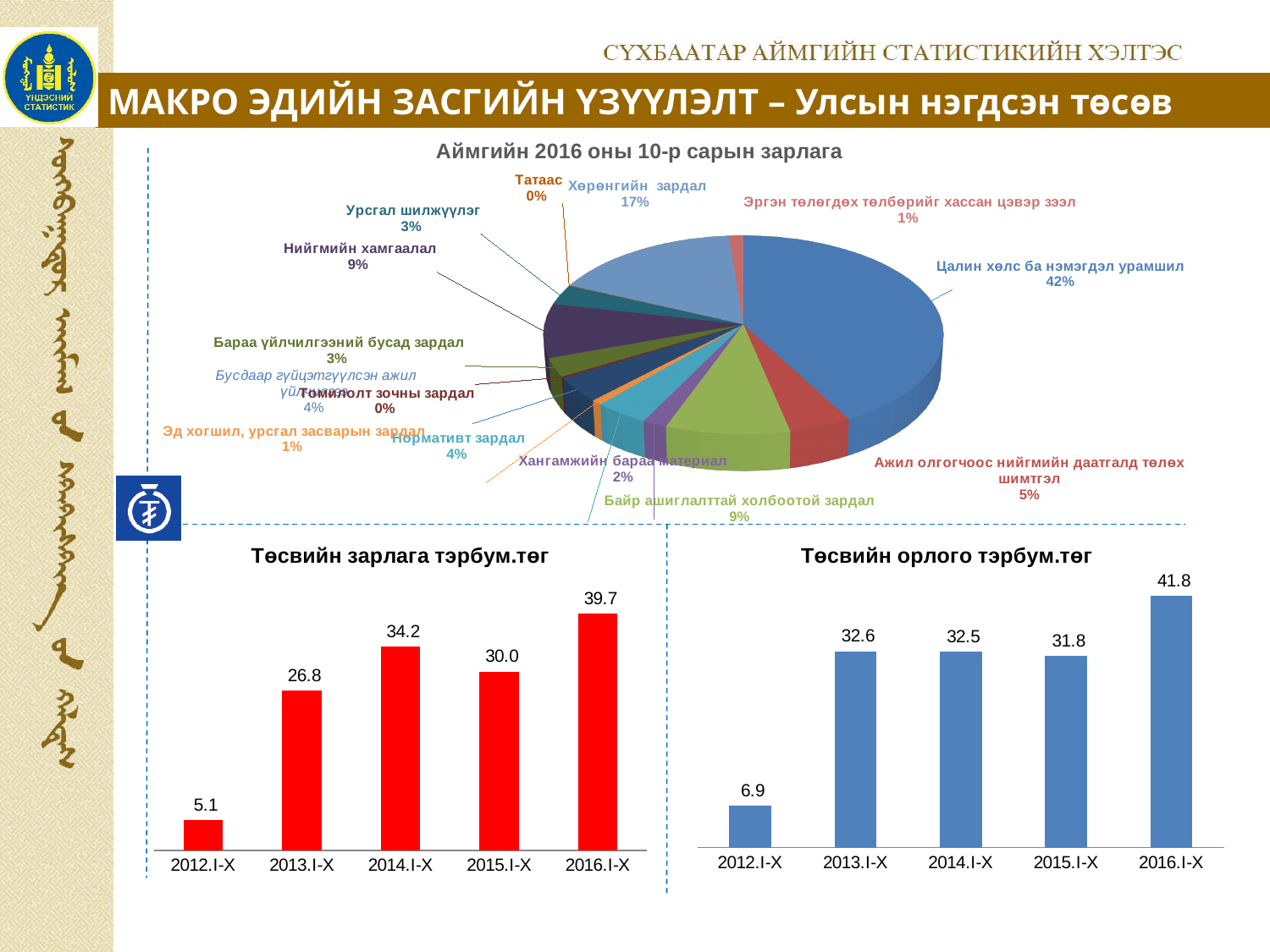
In the 'Төсвийн орлого тэрбум.төг' chart, what is the value for 2013.I-X? 32.6 In the 'Аймгийн 2016 оны 10-р сарын зарлага' pie chart, what share does 'Цалин хөлс ба нэмэгдэл урамшил' have? 42% In the 'Төсвийн зарлага тэрбум.төг' chart, which is larger: the value for 2013.I-X or 2015.I-X? 2015.I-X What kind of chart is 'Төсвийн орлого тэрбум.төг'? Bar chart What kind of chart is 'Аймгийн 2016 оны 10-р сарын зарлага'? Pie chart In the 'Төсвийн орлого тэрбум.төг' chart, what is the difference between the values for 2016.I-X and 2012.I-X? 34.9 How many periods are shown on the x axis of the 'Төсвийн орлого тэрбум.төг' chart? 5 In the 'Төсвийн зарлага тэрбум.төг' chart, what is the difference between the values for 2014.I-X and 2015.I-X? 4.2 In the 'Аймгийн 2016 оны 10-р сарын зарлага' pie chart, what share does 'Хөрөнгийн зардал' have? 17% In the 'Төсвийн зарлага тэрбум.төг' chart, which period has the lowest value? 2012.I-X In the 'Төсвийн орлого тэрбум.төг' chart, which period has the highest value? 2016.I-X In the 'Төсвийн зарлага тэрбум.төг' chart, what is the value for 2016.I-X? 39.7